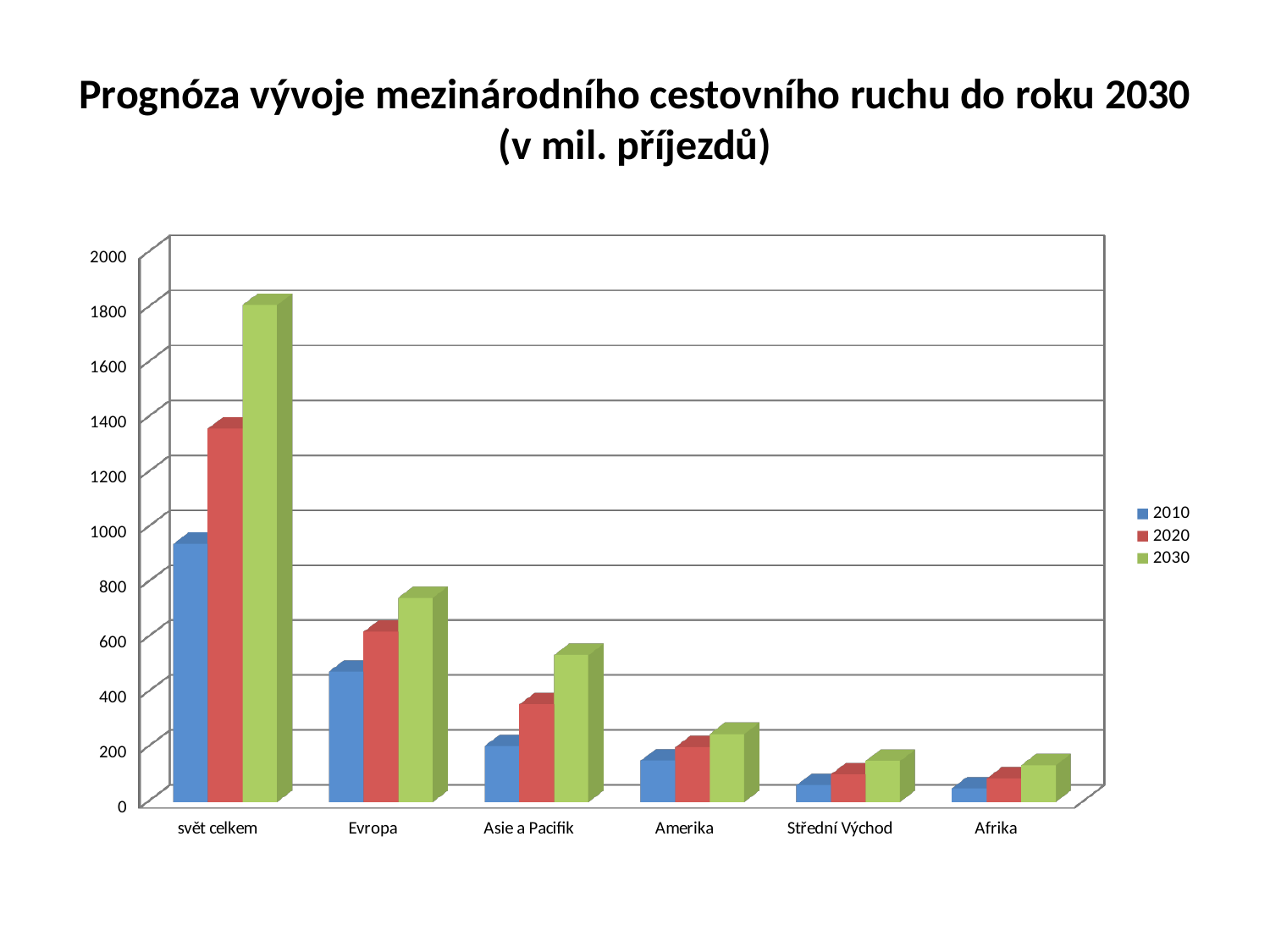
Is the value for svět celkem in 2030 greater or less than 1600? greater How many categories are shown on the x axis? 6 Do the values for Evropa rise or fall from 2010 to 2030? rise Is the value for svět celkem in 2010 greater or less than 1000? less How many series does the legend list? 3 Which is larger for 2020: Amerika or Asie a Pacifik? Asie a Pacifik Is the value for Amerika in 2030 greater or less than 400? less Which category has the highest value for 2030? svět celkem Which is larger for 2030: Evropa or Asie a Pacifik? Evropa What kind of chart is shown on the slide? bar chart